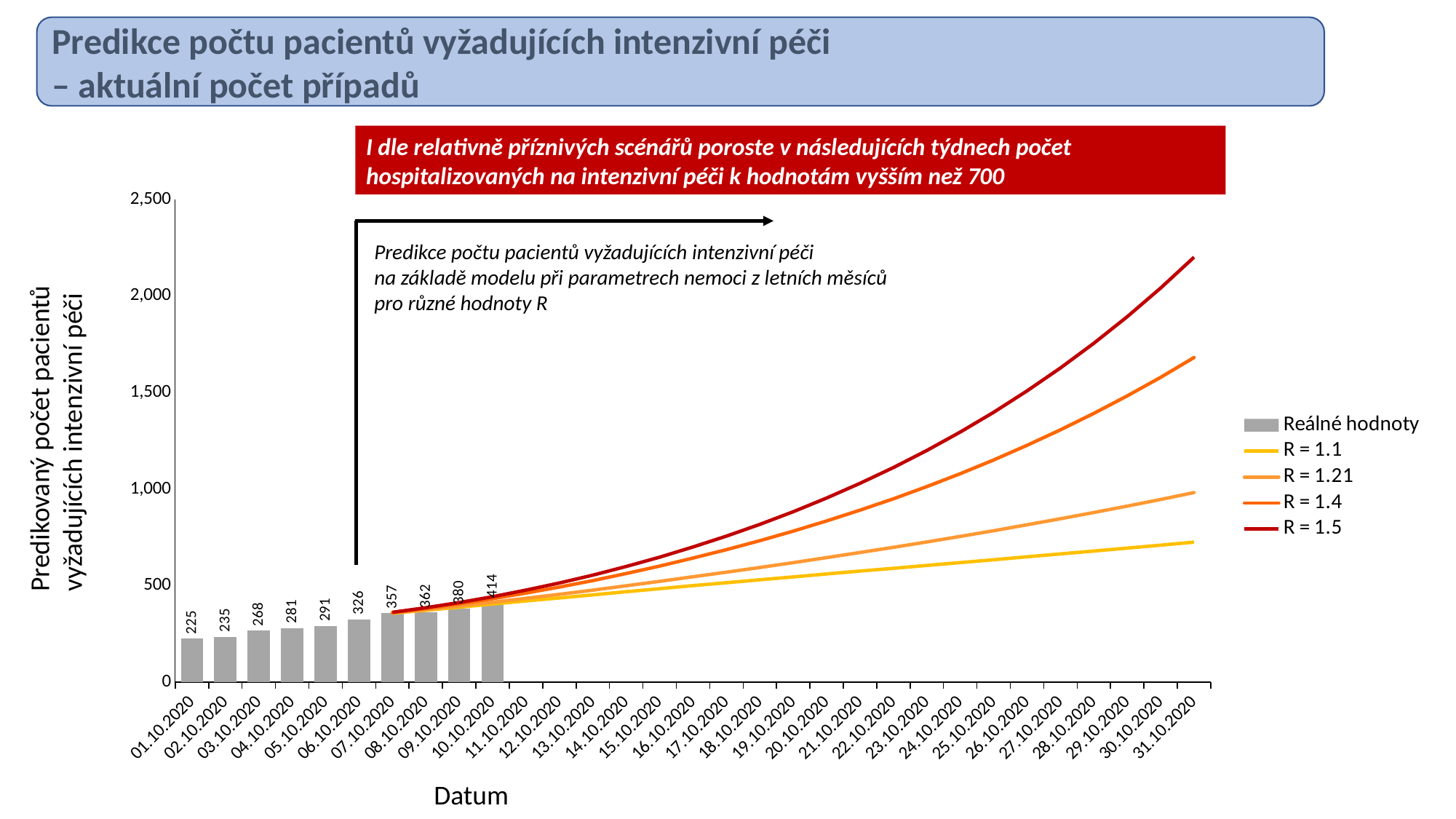
What is the value of the Reálné hodnoty bar for 01.10.2020? 225 What is the difference between the Reálné hodnoty values for 10.10.2020 and 01.10.2020? 189 How many Reálné hodnoty bars are plotted on the chart? 10 What is the value of the Reálné hodnoty bar for 06.10.2020? 326 Is the value of the R = 1.5 line on 31.10.2020 greater or less than 2,000? greater Which date has the highest Reálné hodnoty bar? 10.10.2020 What is the value of the Reálné hodnoty bar for 10.10.2020? 414 Do the Reálné hodnoty bars rise or fall from 01.10.2020 to 10.10.2020? rise How many series does the legend list? 5 Which date has the lowest Reálné hodnoty bar? 01.10.2020 Is the value of the R = 1.1 line on 31.10.2020 greater or less than 1,000? less Which is larger, the Reálné hodnoty value for 04.10.2020 or for 09.10.2020? 09.10.2020